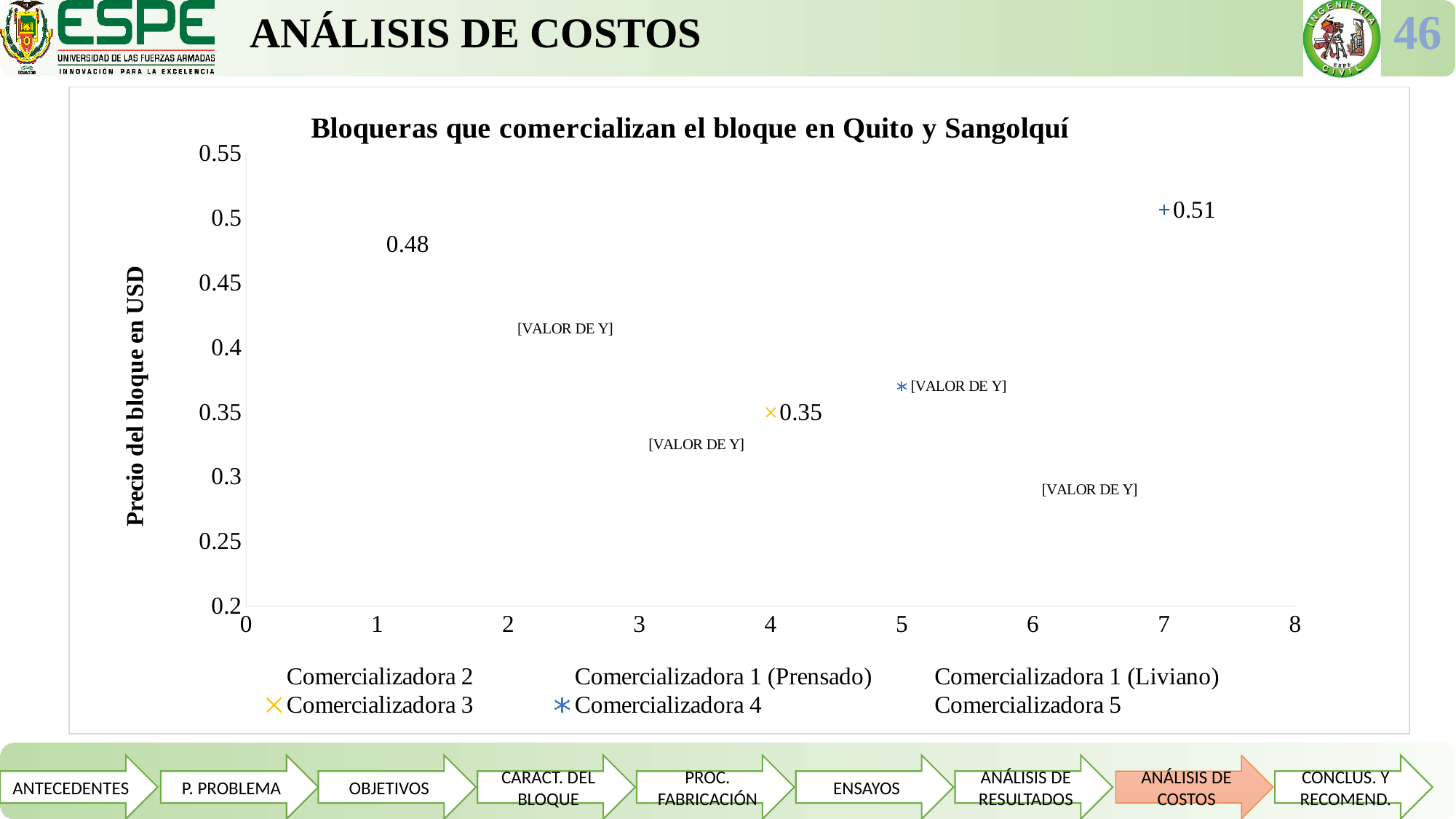
How many series does the legend list? 6 Is the price for Comercializadora 4 greater or less than 0.35? greater What is the difference between the highest labeled price (0.51) and the price for Comercializadora 3 (0.35)? 0.16 Which has the higher price, Comercializadora 3 or Comercializadora 4? Comercializadora 4 What is the title of the chart? Bloqueras que comercializan el bloque en Quito y Sangolquí What is the highest price labeled on the chart? 0.51 What is the difference between the labeled prices 0.51 and 0.48? 0.03 What price is labeled for the point at x = 1? 0.48 How many data points are plotted on the chart? 7 What kind of chart is shown on the slide? scatter chart What is the y-axis title of the chart? Precio del bloque en USD What is the price shown for Comercializadora 3? 0.35